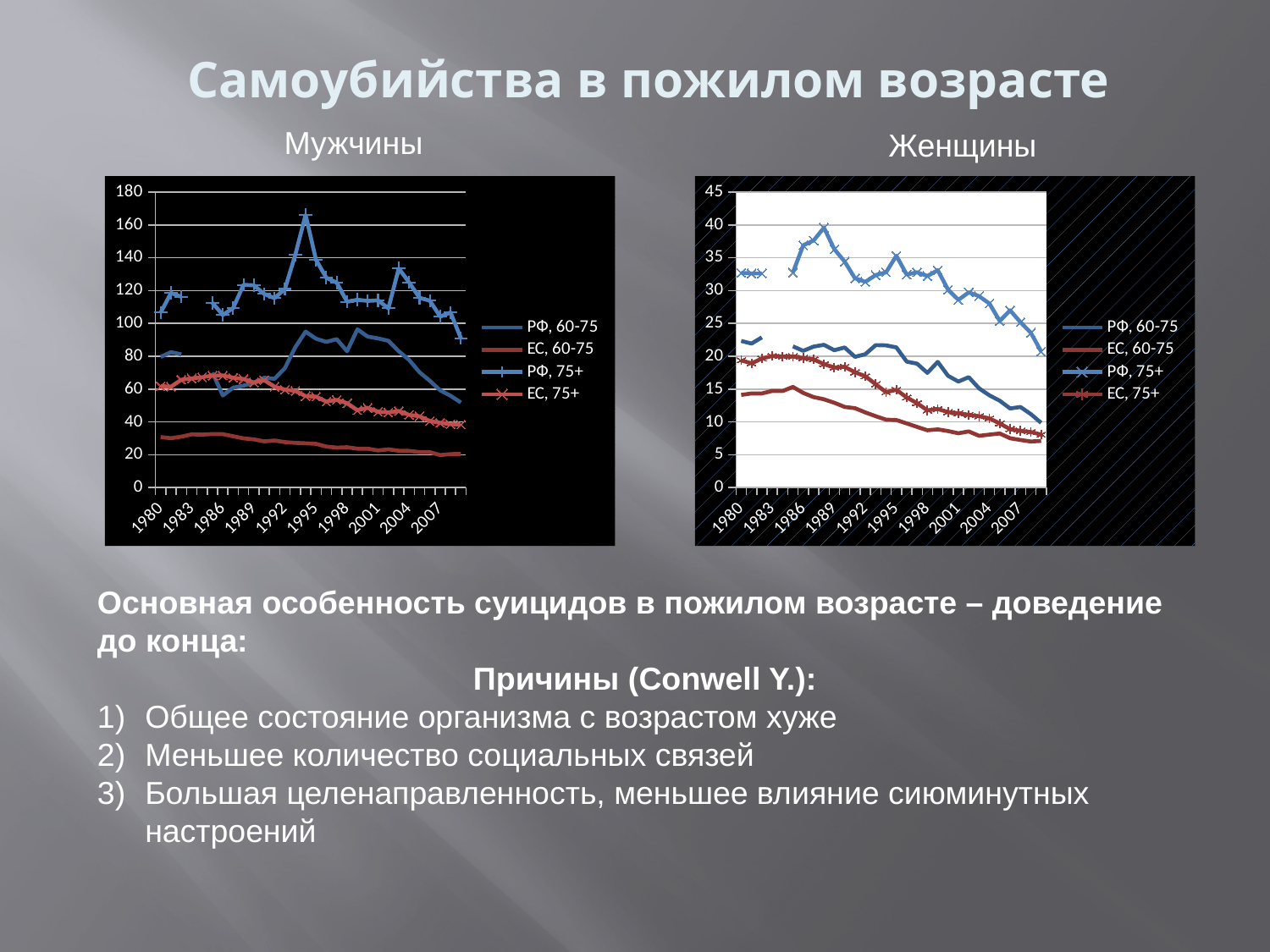
In the "Мужчины" chart, is the peak value of the РФ, 75+ series around 1995 greater or less than 140? greater What kind of chart is the "Мужчины" chart on the left? line chart In the "Мужчины" chart, which series has the lowest values across the whole period? ЕС, 60-75 What is the highest value shown on the y axis of the "Женщины" chart? 45 What is the first year label on the x axis of the "Мужчины" chart? 1980 In the "Мужчины" chart, which series has the highest values across the whole period? РФ, 75+ In the "Женщины" chart, is the value for ЕС, 60-75 in 1980 greater or less than 20? less In the "Мужчины" chart, which is larger in 1980: the value for РФ, 75+ or the value for ЕС, 75+? РФ, 75+ In the "Женщины" chart, does the ЕС, 60-75 series rise or fall overall from 1980 to the end of the period? fall In the "Мужчины" chart, is the value for ЕС, 60-75 in 1980 greater or less than 40? less How many series does the legend of the "Женщины" chart list? 4